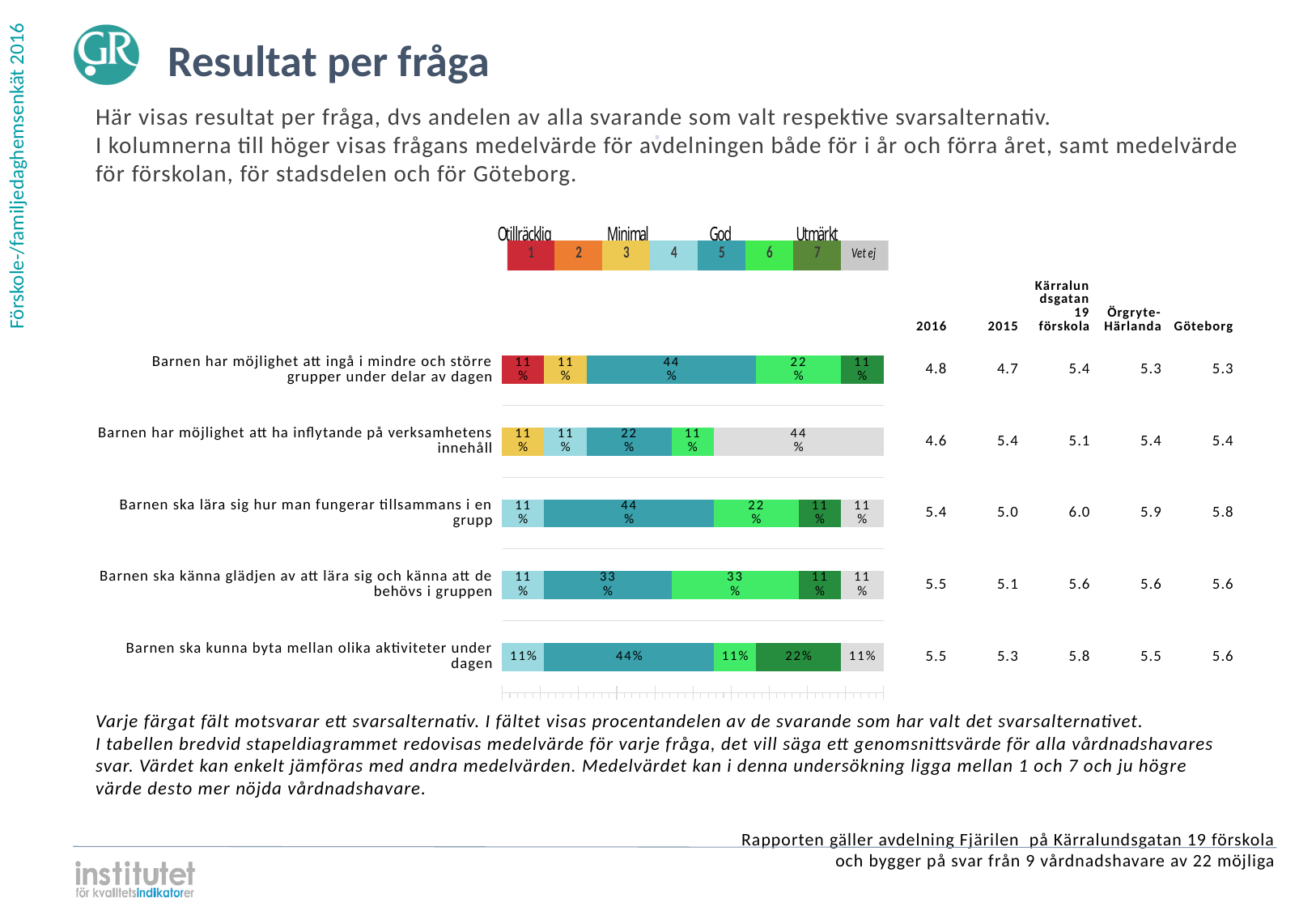
What percentage chose rating 7 (Utmärkt) for 'Barnen ska kunna byta mellan olika aktiviteter under dagen'? 22% Which question has the lowest 2016 mean value in the table? Barnen har möjlighet att ha inflytande på verksamhetens innehåll What is the 2016 mean value for 'Barnen ska känna glädjen av att lära sig och känna att de behövs i gruppen'? 5.5 What percentage of respondents chose rating 5 (God) for 'Barnen har möjlighet att ingå i mindre och större grupper under delar av dagen'? 44% What kind of chart is shown on the slide? Stacked bar chart For 'Barnen ska kunna byta mellan olika aktiviteter under dagen', which is larger: the share for rating 5 or the share for rating 7? Rating 5 Which question is the only one with a red (rating 1, Otillräcklig) segment? Barnen har möjlighet att ingå i mindre och större grupper under delar av dagen What percentage chose 'Vet ej' for 'Barnen har möjlighet att ha inflytande på verksamhetens innehåll'? 44% How many questions (categories) are plotted in the bar chart? 5 How many answer alternatives does the legend above the chart list? 8 For 'Barnen ska lära sig hur man fungerar tillsammans i en grupp', what is the difference between the rating 5 share and the rating 6 share? 22% Which question has the largest 'Vet ej' share? Barnen har möjlighet att ha inflytande på verksamhetens innehåll